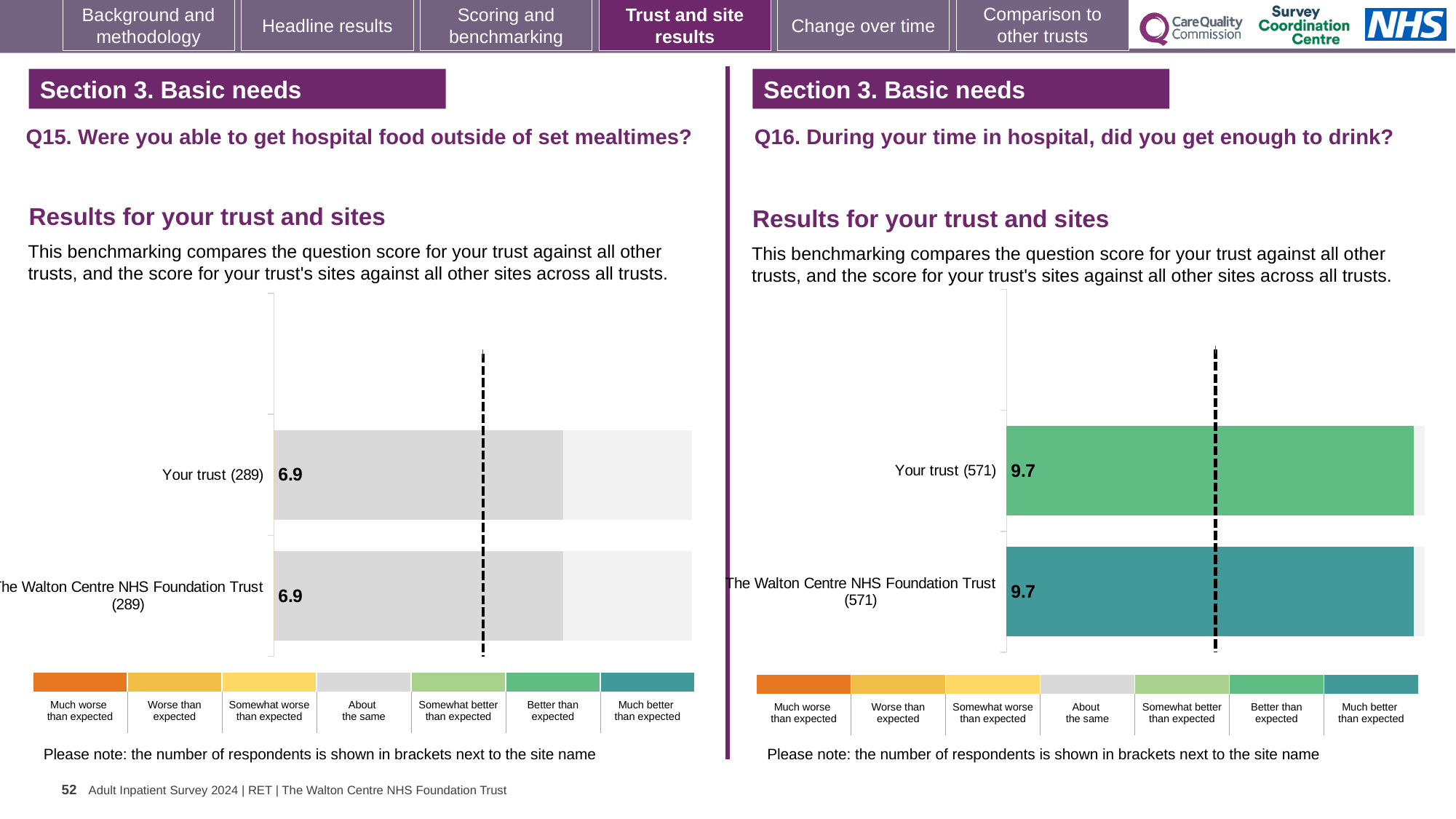
Is the score for Your trust on the Q16 chart (right) larger or smaller than the score for Your trust on the Q15 chart (left)? Larger On the Q15 chart (left), what is the score for Your trust? 6.9 How many bars are plotted on the Q15 chart (left)? 2 On the Q15 chart (left), how many respondents are shown in brackets next to Your trust? 289 On the Q16 chart (right), what is the score for The Walton Centre NHS Foundation Trust? 9.7 On the Q15 chart (left), what is the score for The Walton Centre NHS Foundation Trust? 6.9 What kind of chart is used for the Q16 results (right)? Bar chart On the Q16 chart (right), what is the difference between the score for Your trust and the score for The Walton Centre NHS Foundation Trust? 0 On the Q16 chart (right), how many respondents are shown in brackets next to The Walton Centre NHS Foundation Trust? 571 On the Q15 chart (left), what is the difference between the score for Your trust and the score for The Walton Centre NHS Foundation Trust? 0 How many bars are plotted on the Q16 chart (right)? 2 On the Q16 chart (right), what is the score for Your trust? 9.7